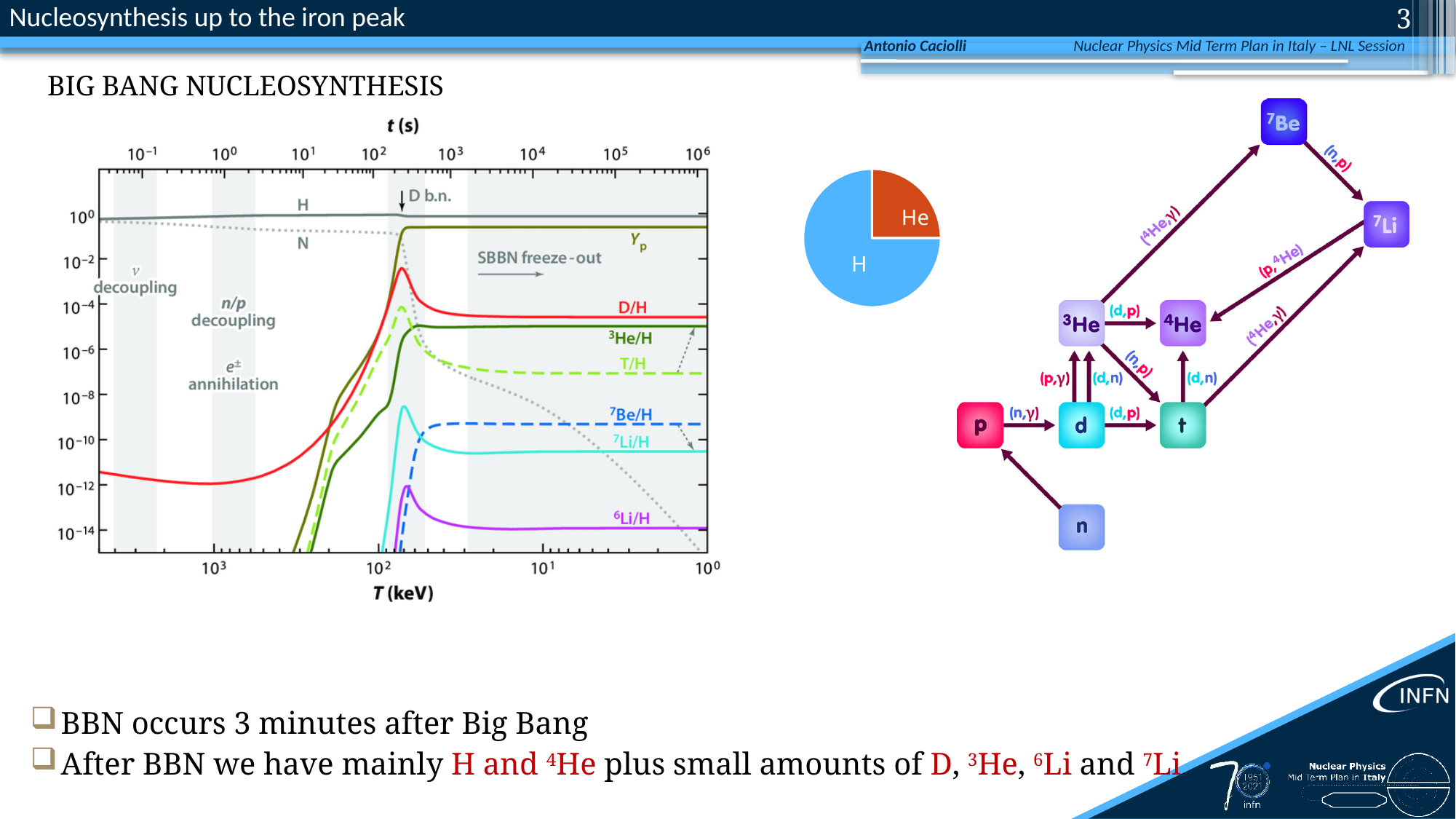
In the line chart on the left, at the right edge of the plot, is the D/H value greater or less than 10^-6? greater What kind of chart is the large chart on the left with T (keV) on the x axis? line chart In the line chart on the left, which labeled curve lies lowest on the y axis at the right edge of the plot? 6Li/H In the line chart on the left, which labeled curve lies highest on the y axis? H In the pie chart, how many slices are there? 2 In the line chart on the left, at the right edge of the plot, which curve is higher, D/H or 3He/H? D/H In the line chart on the left, what is the label of the bottom x axis? T (keV) In the pie chart, which element has the smallest slice? He In the line chart on the left, at the right edge of the plot, is the 6Li/H value greater or less than 10^-12? less In the pie chart, which slice is larger, H or He? H What kind of chart is the small chart on the right showing H and He? pie chart In the line chart on the left, what is the label of the top x axis? t (s)